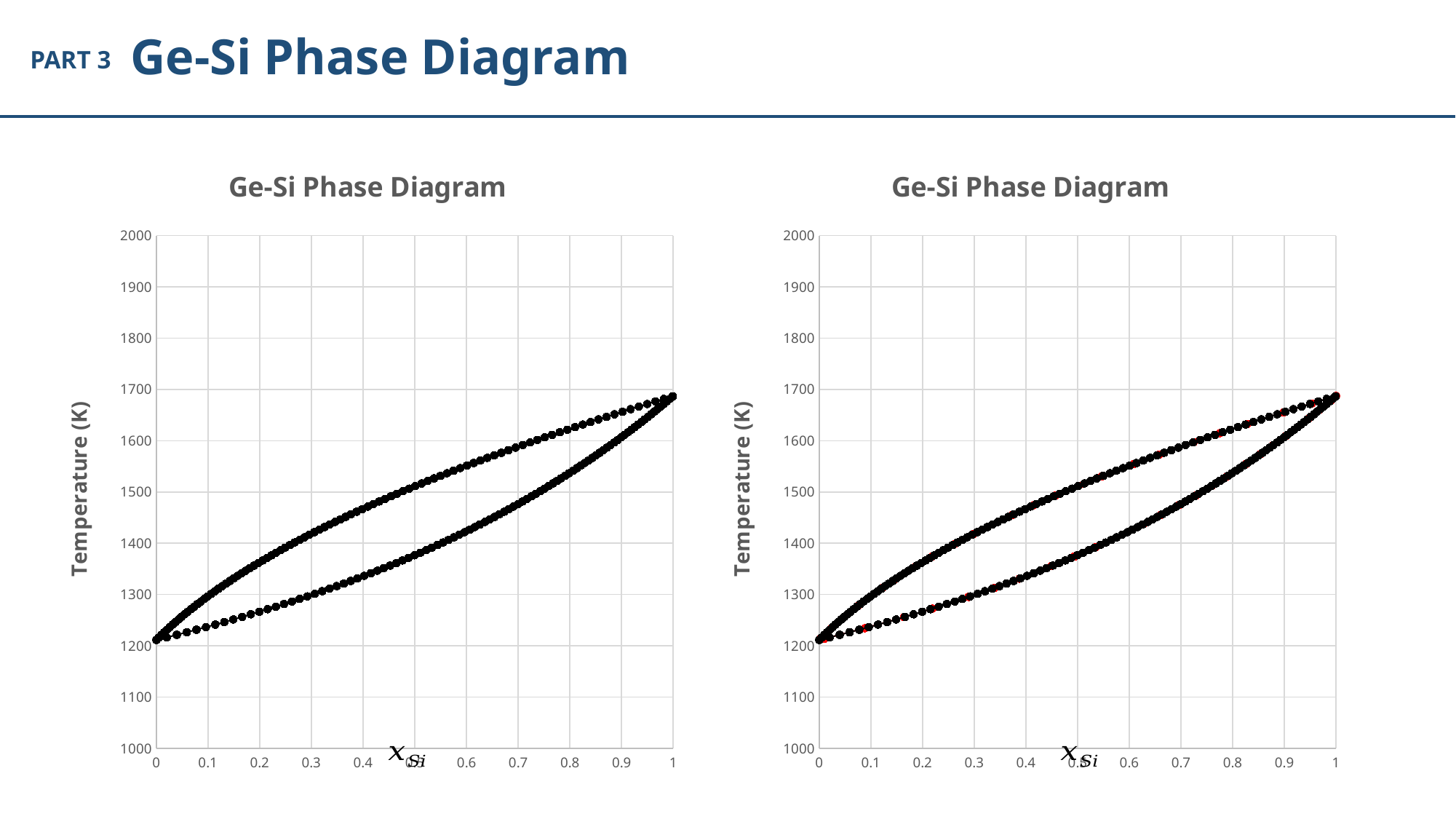
What is the y-axis label of the left chart? Temperature (K) In the left chart, is the temperature of the lower curve at x_Si = 0.2 greater or less than 1300? less In the right chart, is the temperature at x_Si = 1 greater or less than 1700? less In the right chart, is the temperature of the lower curve at x_Si = 0.8 greater or less than 1500? greater What kind of chart is the right chart titled "Ge-Si Phase Diagram"? scatter chart In the left chart, do the plotted temperatures rise or fall as x_Si increases from 0 to 1? rise In the right chart, do the plotted temperatures rise or fall as x_Si increases from 0 to 1? rise What is the title of the right chart? Ge-Si Phase Diagram What kind of chart is the left chart titled "Ge-Si Phase Diagram"? scatter chart In the left chart, at x_Si = 0.5, which curve has the higher temperature, the upper curve or the lower curve? the upper curve